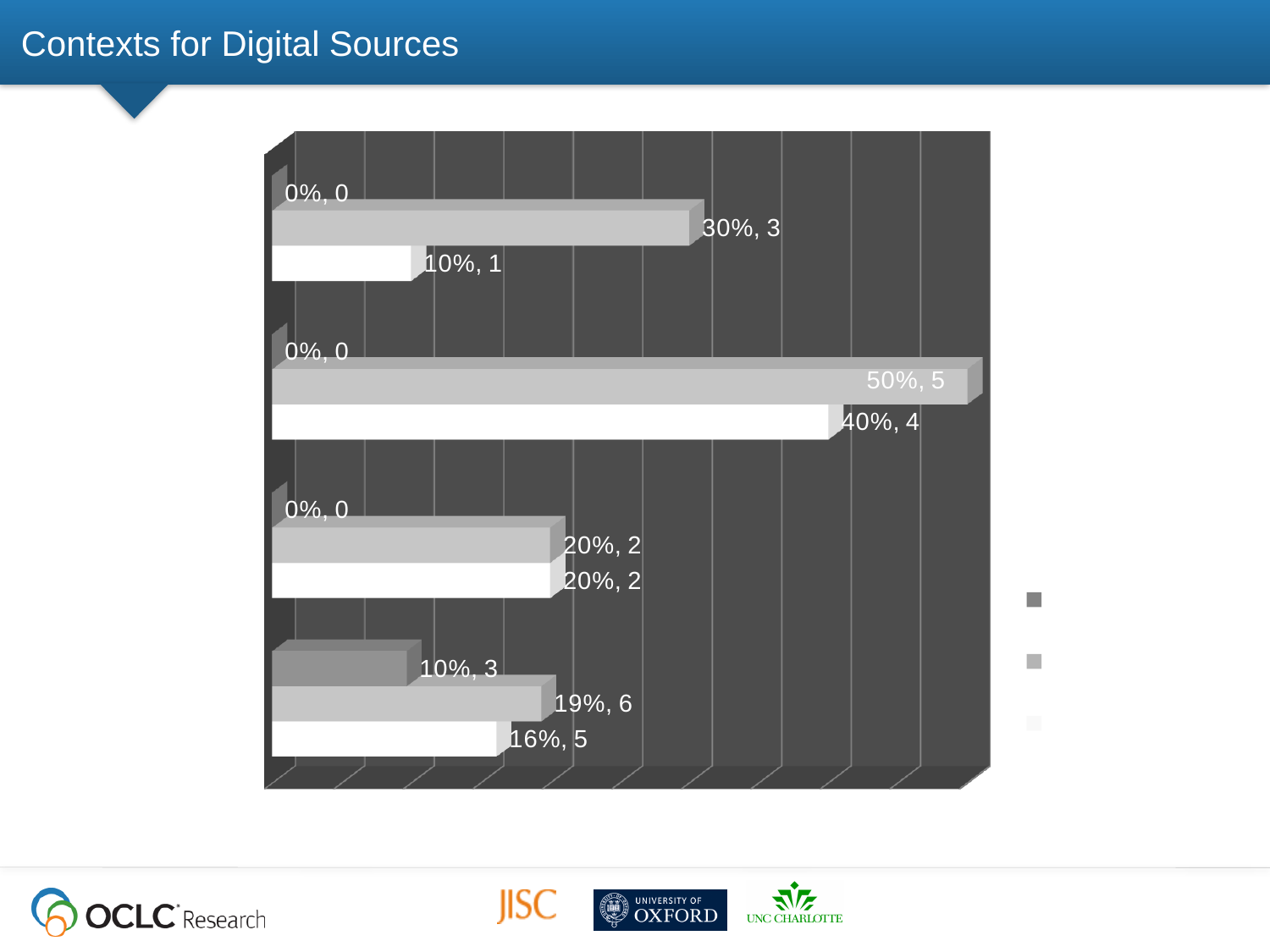
In the top group, what is the difference in percentage between the light grey bar and the white bar? 20% What is the data label on the dark grey bar in the bottom group? 10%, 3 How many series does the chart's legend list? 3 In the bottom group, which is larger: the light grey bar or the white bar? the light grey bar What is the data label on the white bar in the top group? 10%, 1 In the second group from the top, what is the difference in percentage between the light grey bar and the white bar? 10% How many groups of bars does the chart show? 4 What is the data label on the light grey bar in the second group from the top? 50%, 5 Which bar in the chart has the highest percentage? the light grey bar in the second group from the top (50%, 5) What is the data label on the dark grey bar in the top group? 0%, 0 What is the data label on the light grey bar in the bottom group? 19%, 6 What kind of chart is shown on the slide? bar chart